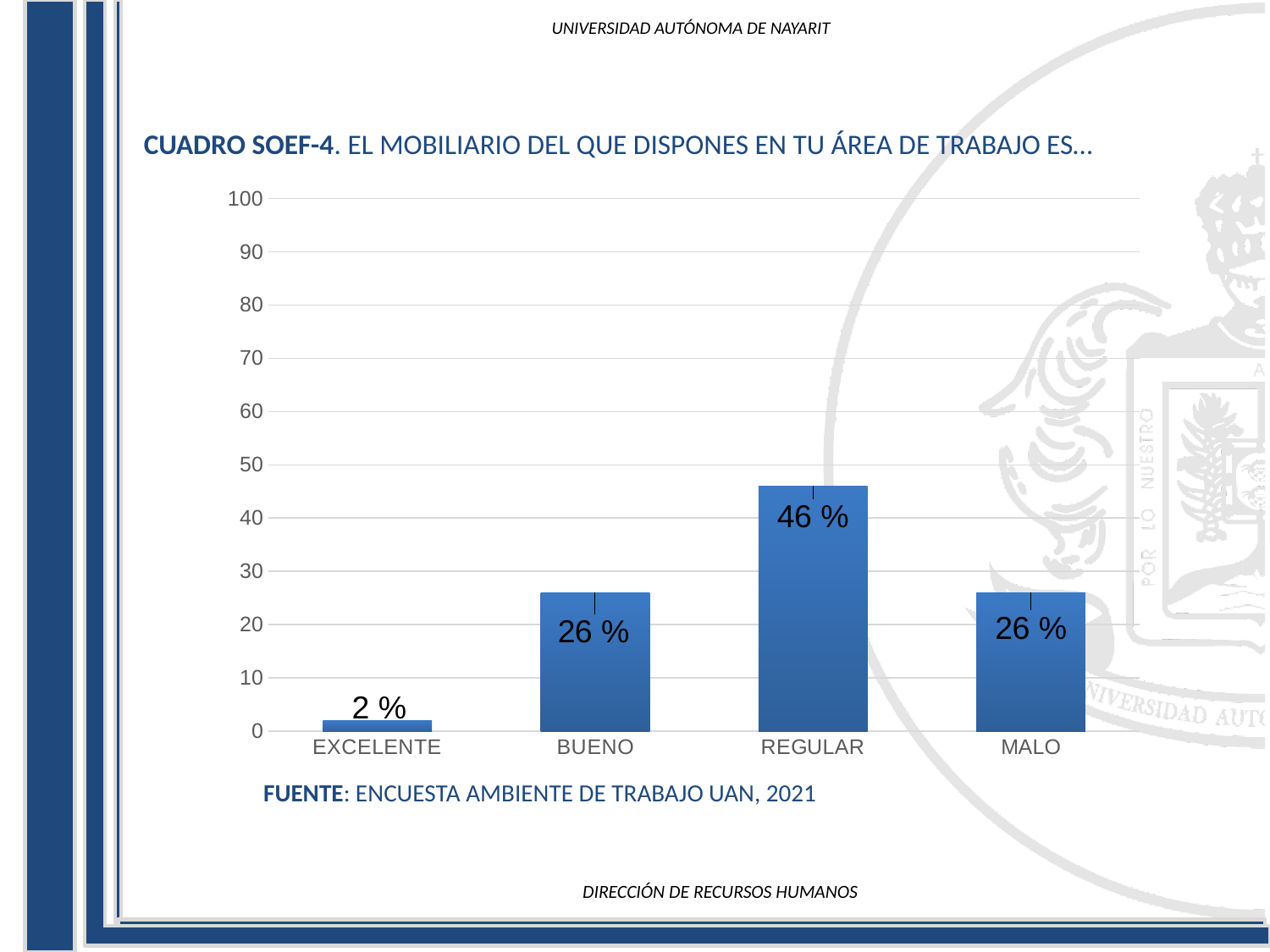
What is the source cited below the chart? ENCUESTA AMBIENTE DE TRABAJO UAN, 2021 What is the title of the chart? CUADRO SOEF-4. EL MOBILIARIO DEL QUE DISPONES EN TU ÁREA DE TRABAJO ES… Which category has the highest value? REGULAR What is the value for EXCELENTE? 2 % What is the value for REGULAR? 46 % How many categories are shown on the x axis? 4 What is the value for BUENO? 26 % What kind of chart is shown on the slide? bar chart Which category has the lowest value? EXCELENTE Is the value for REGULAR greater or less than 50? less Which is larger, the value for BUENO or the value for EXCELENTE? BUENO What is the difference between the values for REGULAR and MALO? 20 %